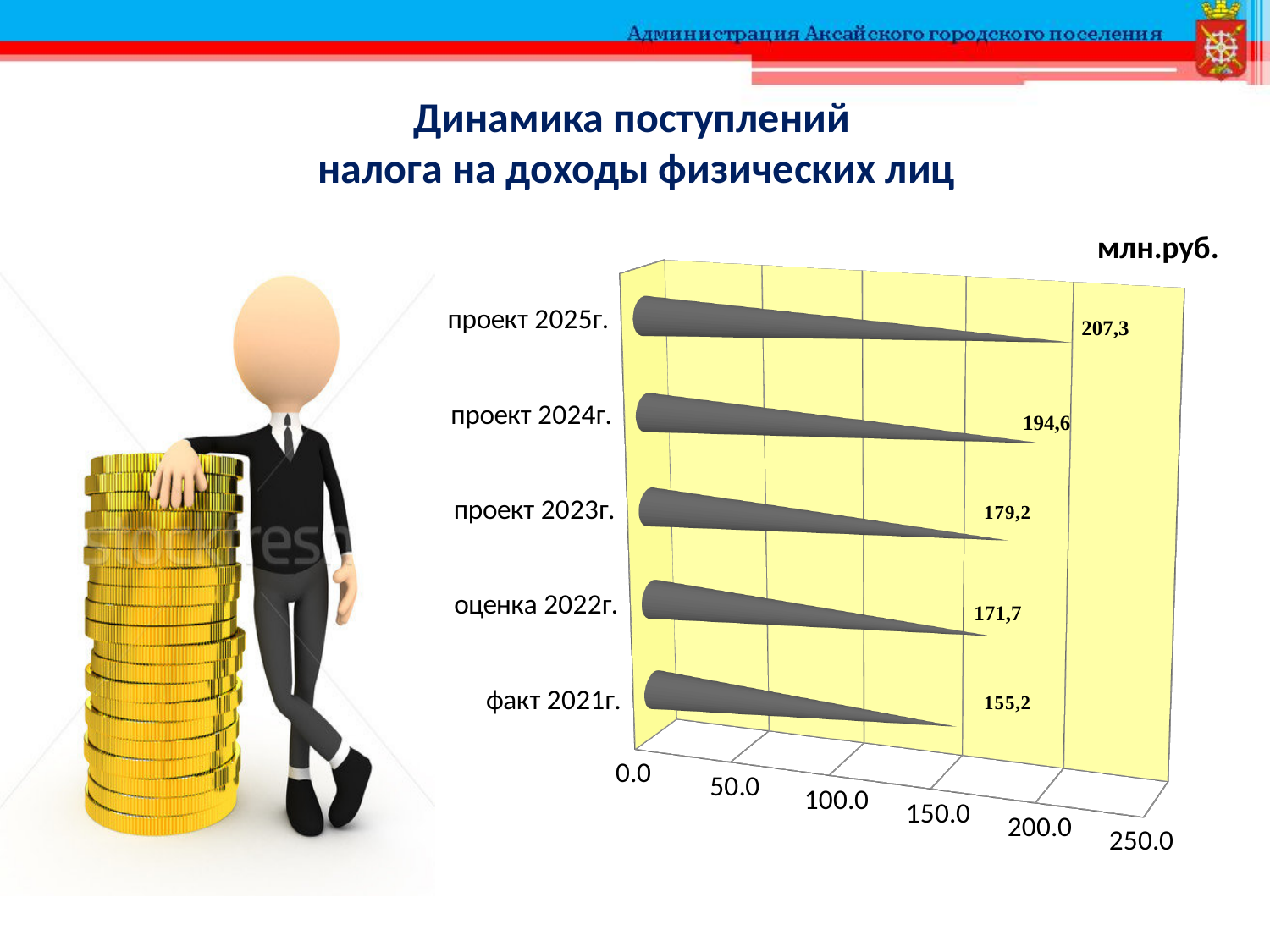
Which category has the lowest value? факт 2021г. What is the difference between the values for проект 2025г. and факт 2021г.? 52,1 What is the value for оценка 2022г.? 171,7 Which is larger, the value for проект 2024г. or the value for оценка 2022г.? проект 2024г. Do the values rise or fall from факт 2021г. to проект 2025г.? rise What is the value for проект 2023г.? 179,2 Which category has the highest value? проект 2025г. What is the value for проект 2025г.? 207,3 What is the difference between the values for проект 2024г. and проект 2023г.? 15,4 How many categories are shown in the chart? 5 What is the value for факт 2021г.? 155,2 What kind of chart is shown on the slide? bar chart